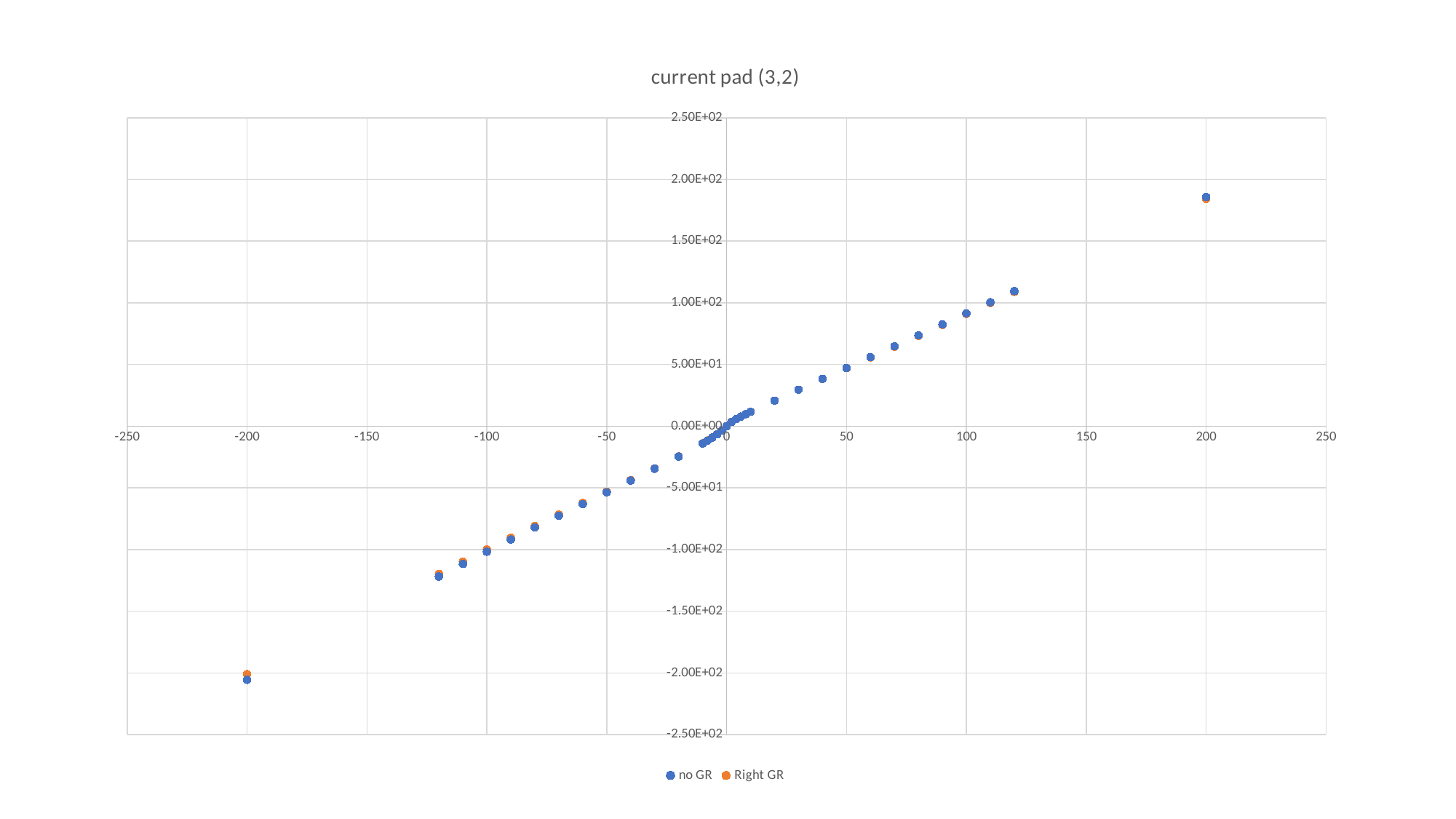
Is the no GR value at x = 120 greater or less than 1.00E+02? greater How many series does the legend list? 2 Is the no GR value at x = 50 greater or less than 1.00E+02? less Is the no GR value at x = 100 greater or less than 5.00E+01? greater What kind of chart is shown on the slide? scatter chart What is the title of the chart? current pad (3,2) Which series is plotted in orange? Right GR Which is larger for the no GR series: the value at x = 200 or the value at x = 100? the value at x = 200 Do the plotted values rise or fall as the x value increases from -200 to 200? rise